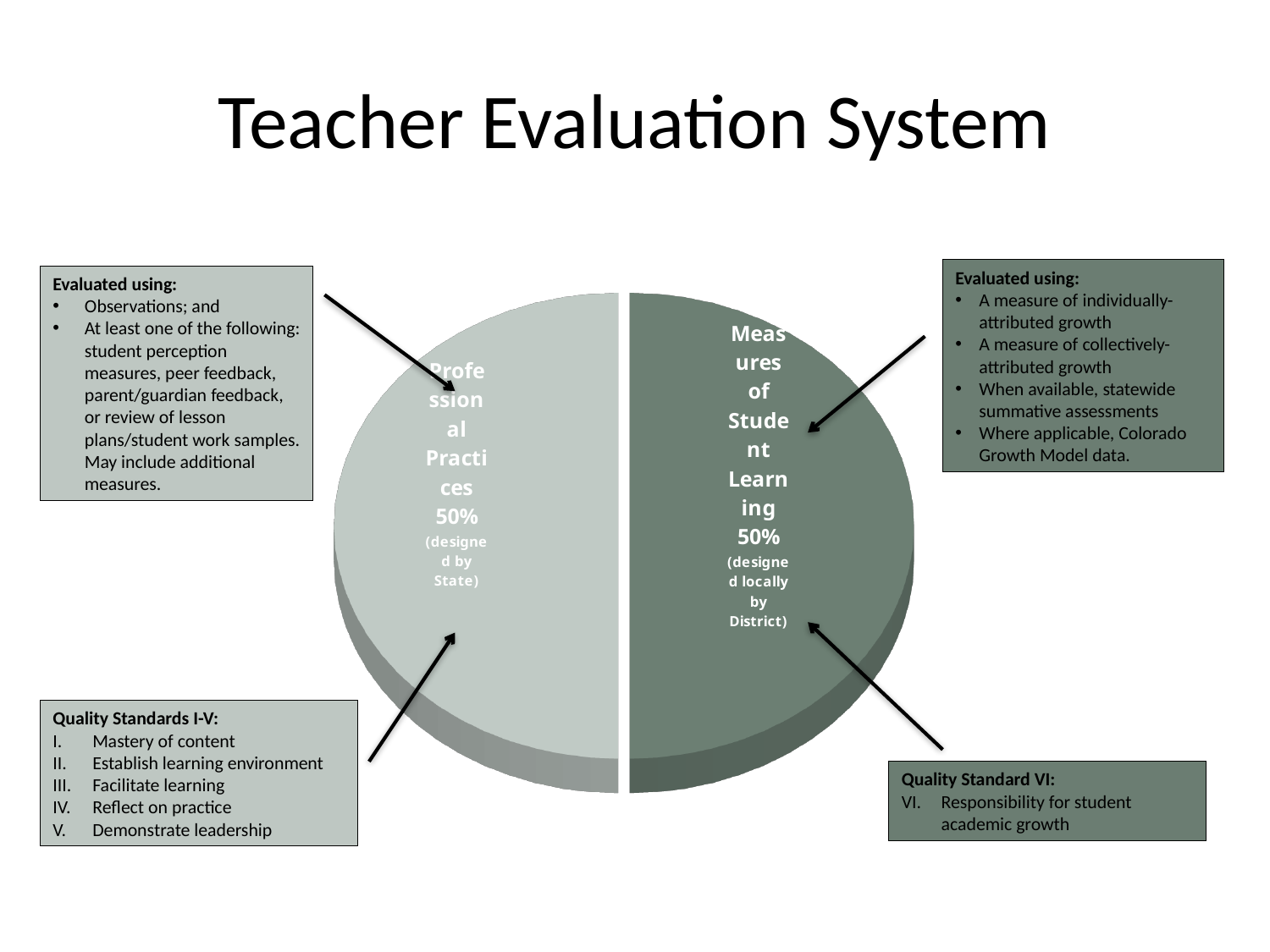
According to the slice label, who designs the Measures of Student Learning component? District What percentage is shown for the Professional Practices slice? 50% What share of the pie does the Measures of Student Learning slice represent? 50% Is the value for Professional Practices greater or less than 40%? greater How many slices does the pie chart have? 2 What kind of chart is shown on the slide? pie chart According to the slice label, who designs the Professional Practices component? State What share of the pie does the Professional Practices slice represent? 50% What percentage is shown for the Measures of Student Learning slice? 50% Is the value for Measures of Student Learning greater or less than 60%? less